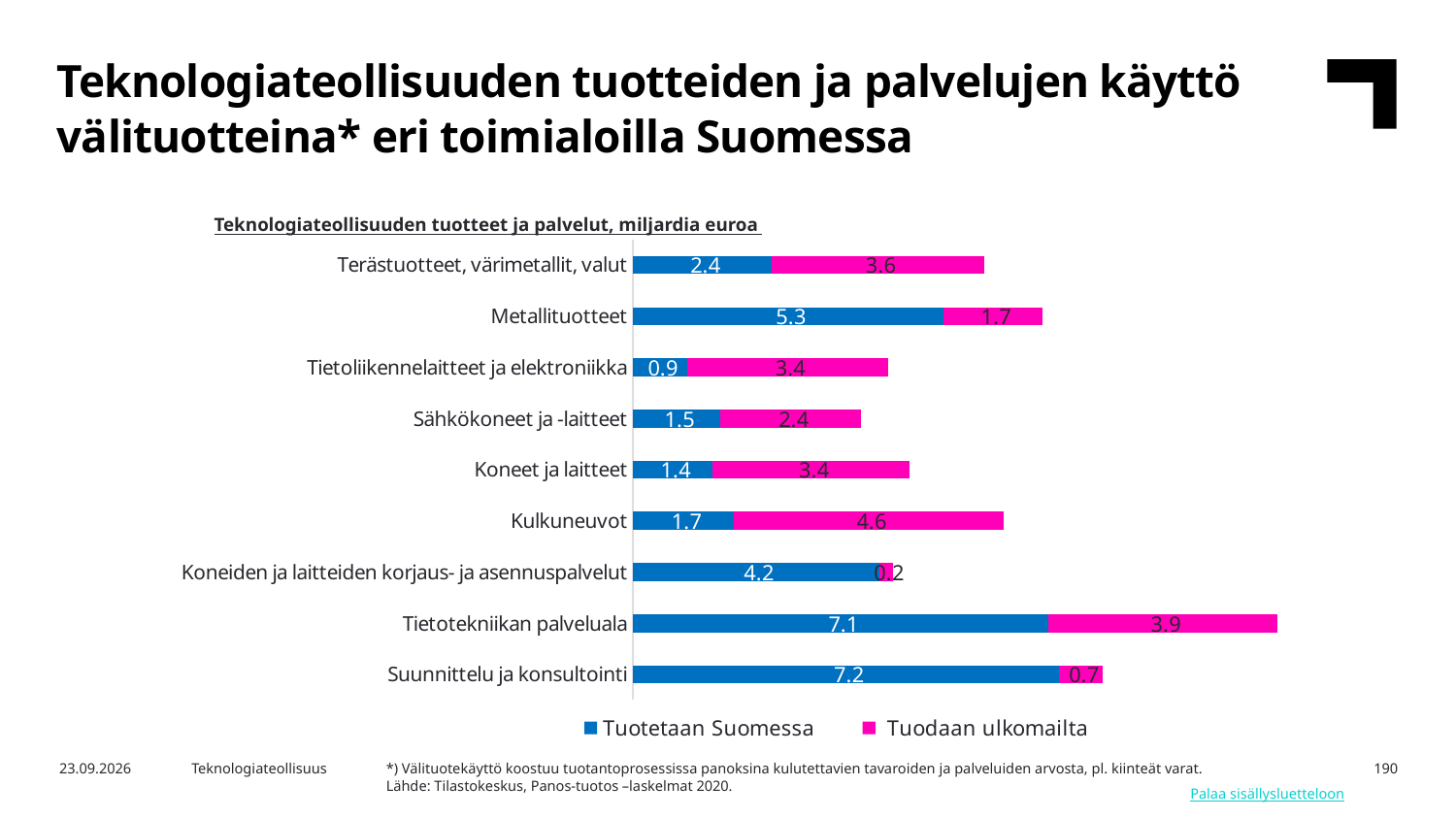
Which category has the lowest 'Tuotetaan Suomessa' value? Tietoliikennelaitteet ja elektroniikka What is the difference between the 'Tuodaan ulkomailta' value for Terästuotteet, värimetallit, valut and the 'Tuodaan ulkomailta' value for Metallituotteet? 1.9 What is the 'Tuodaan ulkomailta' value for Kulkuneuvot? 4.6 Which category has the highest 'Tuodaan ulkomailta' value? Kulkuneuvot What is the 'Tuotetaan Suomessa' value for Metallituotteet? 5.3 How many series does the legend list? 2 Which is larger: the 'Tuotetaan Suomessa' value for Koneiden ja laitteiden korjaus- ja asennuspalvelut or the 'Tuotetaan Suomessa' value for Sähkökoneet ja -laitteet? Koneiden ja laitteiden korjaus- ja asennuspalvelut What is the 'Tuotetaan Suomessa' value for Tietotekniikan palveluala? 7.1 What is the total of the stacked bar for Kulkuneuvot? 6.3 Which category has the lowest 'Tuodaan ulkomailta' value? Koneiden ja laitteiden korjaus- ja asennuspalvelut How many categories (industries) are shown in the chart? 9 What type of chart is shown on the slide? Stacked bar chart